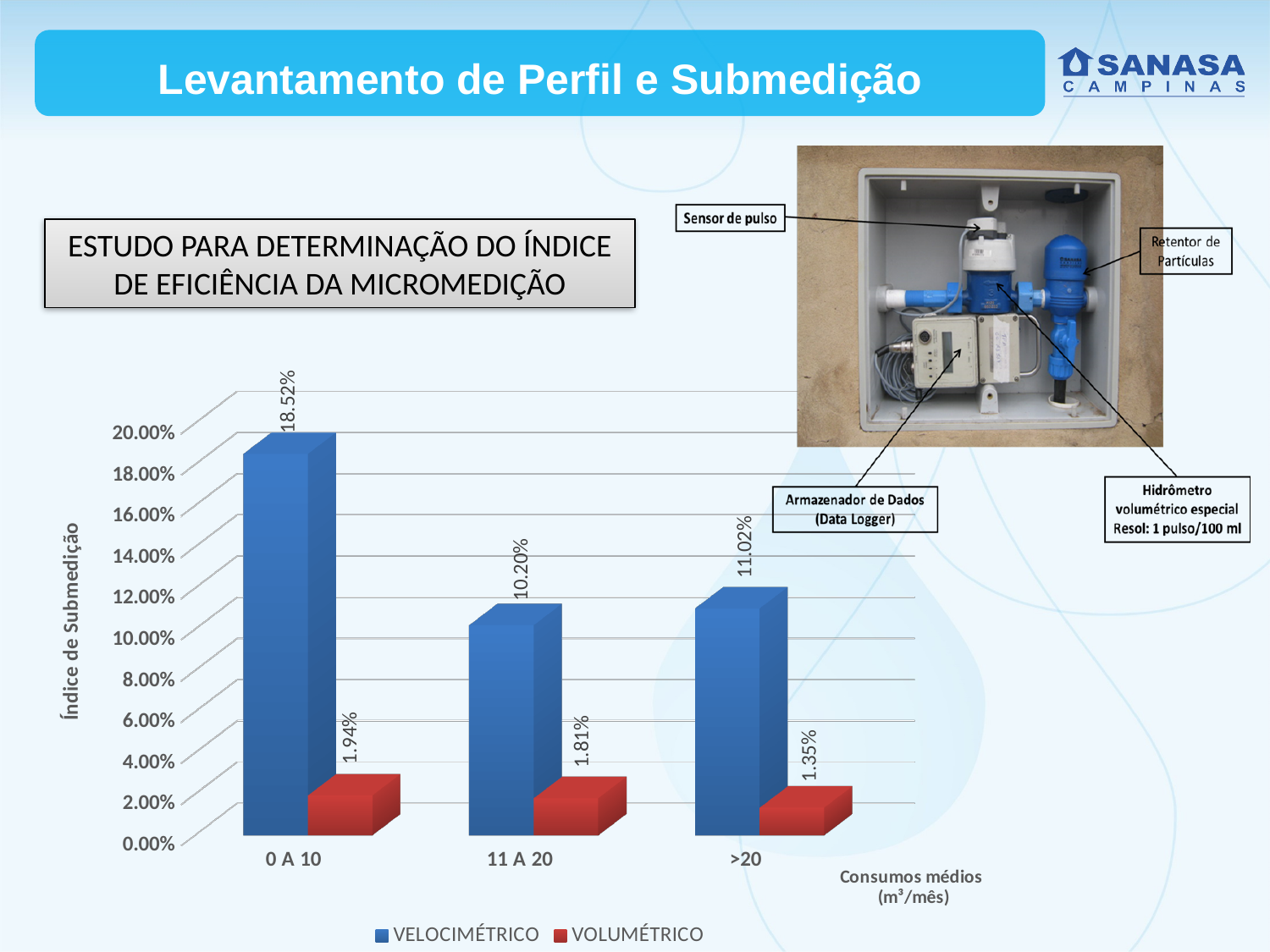
Which is larger, the VELOCIMÉTRICO value for 11 A 20 or for >20? >20 What is the VELOCIMÉTRICO value for the 11 A 20 category? 10.20% Is the VELOCIMÉTRICO value for >20 greater or less than 10.00%? greater What is the label of the y axis of the chart? Índice de Submedição What is the VELOCIMÉTRICO value for the 0 A 10 category? 18.52% Which category has the lowest VOLUMÉTRICO value? >20 How many series does the legend list? 2 How many categories are shown on the x axis? 3 What is the VOLUMÉTRICO value for the >20 category? 1.35% What kind of chart is shown on the slide? Bar chart Which category has the highest VELOCIMÉTRICO value? 0 A 10 What is the difference between the VELOCIMÉTRICO and VOLUMÉTRICO values for the 0 A 10 category? 16.58%